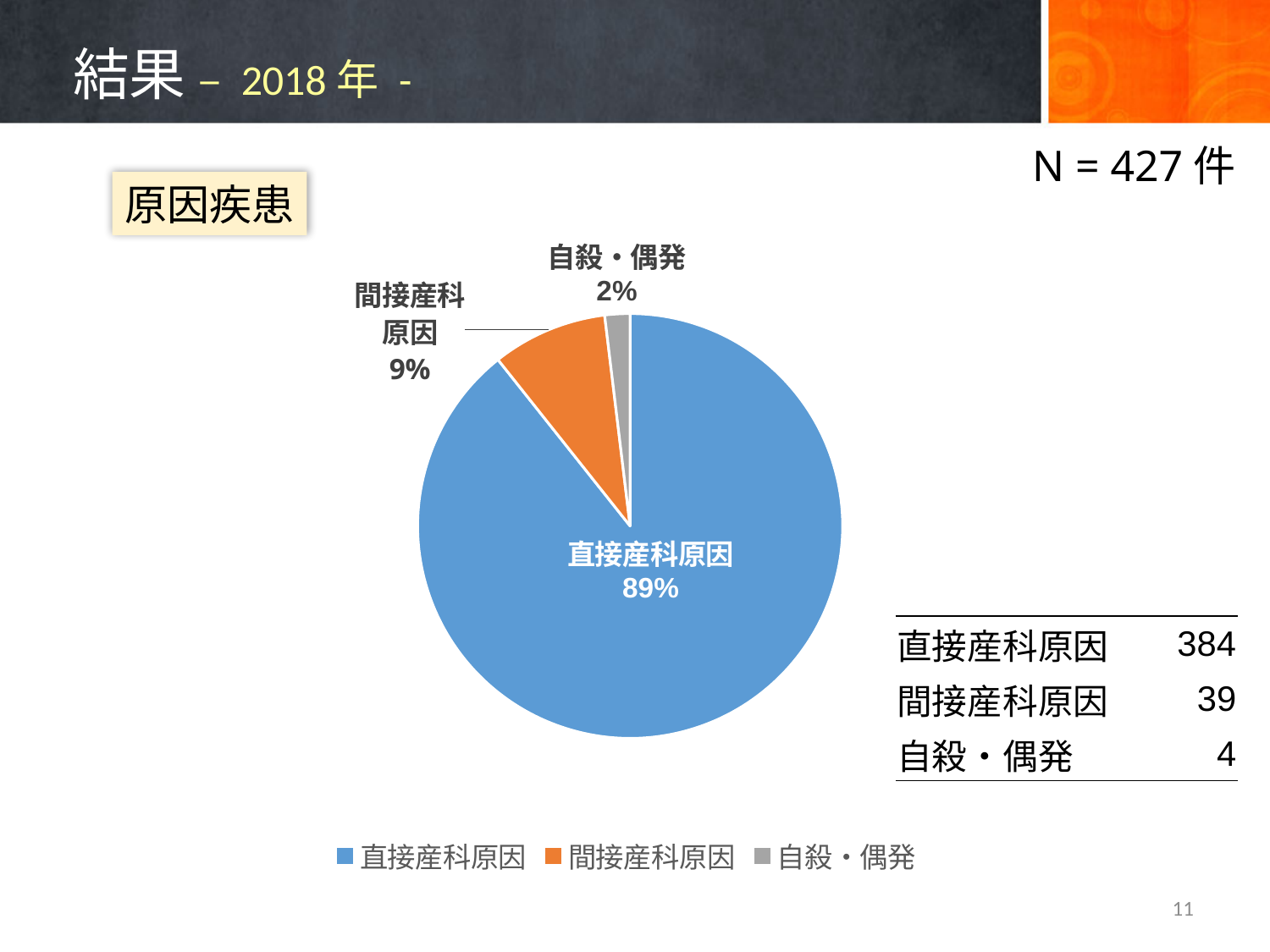
What share of the pie does 自殺・偶発 represent? 2% How many entries does the legend list? 3 What share of the pie does 間接産科原因 represent? 9% Which is larger, the share for 間接産科原因 or the share for 自殺・偶発? 間接産科原因 What is the difference in percentage points between the 直接産科原因 slice and the 間接産科原因 slice? 80 What colour is the 直接産科原因 slice in the pie chart? blue Which category has the smallest slice of the pie? 自殺・偶発 What share of the pie does 直接産科原因 represent? 89% How many slices does the pie chart have? 3 What kind of chart is shown on the slide? pie chart What colour is the 間接産科原因 slice in the pie chart? orange Which category has the largest slice of the pie? 直接産科原因